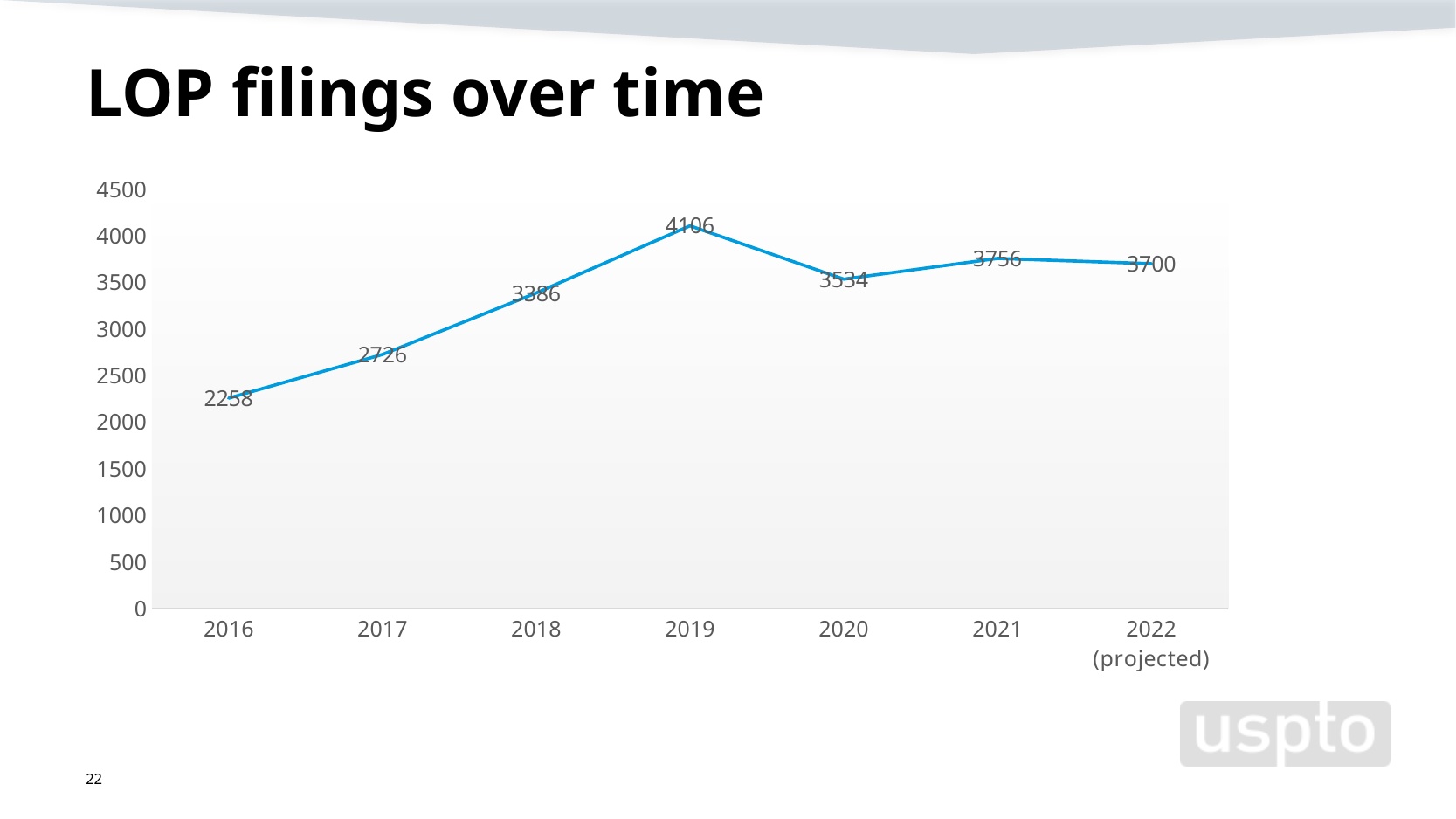
What kind of chart is shown on the slide? line chart What is the value for 2016? 2258 What is the value for 2019? 4106 Do the values rise or fall from 2016 to 2019? rise Which year has the highest value? 2019 How many years are plotted on the chart? 7 Which is larger, the value for 2021 or the value for 2020? 2021 What is the projected value for 2022? 3700 Is the value for 2018 greater or less than 3000? greater What is the difference between the values for 2019 and 2020? 572 Which year has the lowest value? 2016 What is the difference between the values for 2017 and 2016? 468